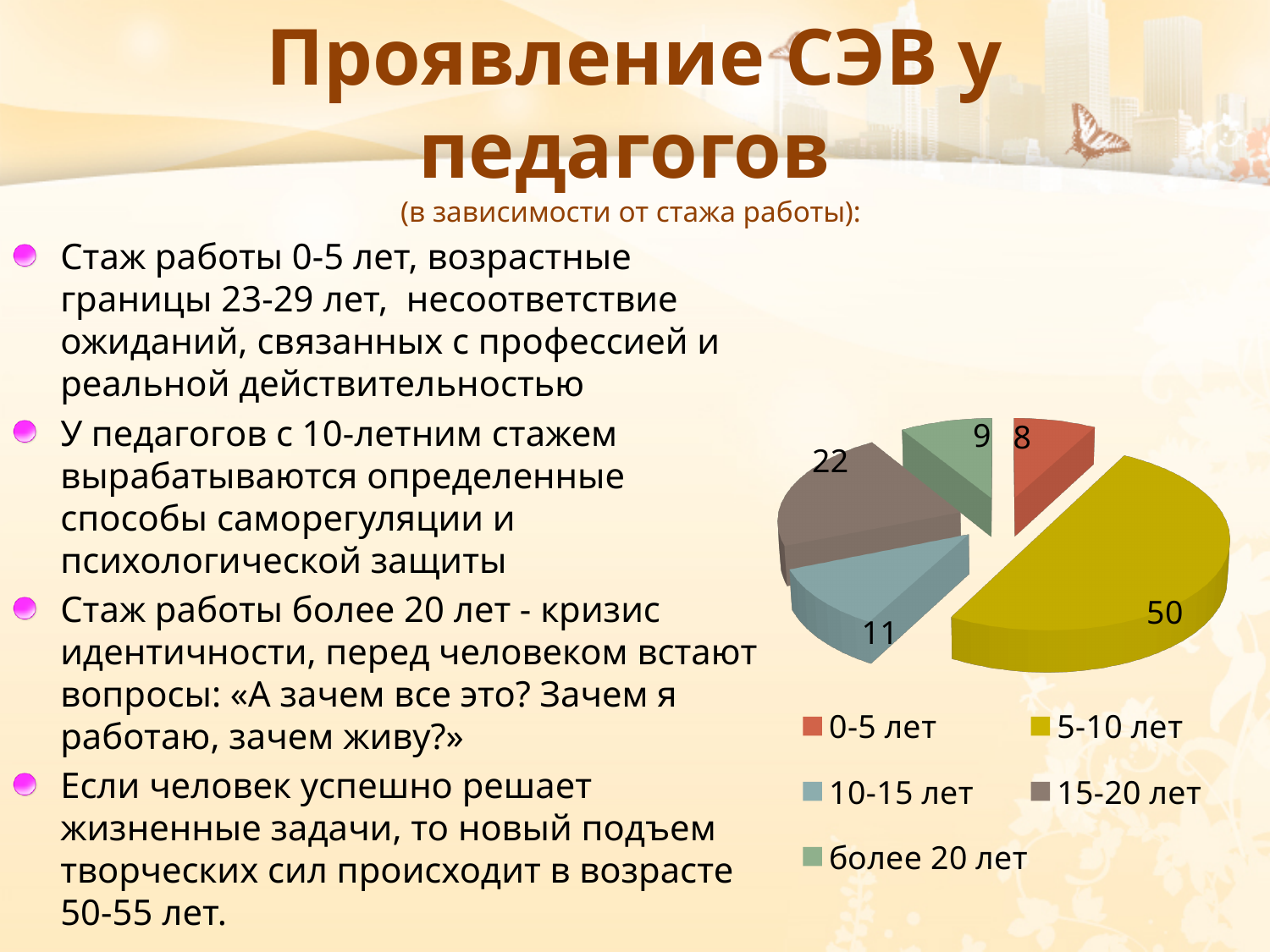
What share of the pie does the "5-10 лет" slice represent? 50% What is the value for the "более 20 лет" slice? 9 Which category has the largest slice of the pie? 5-10 лет What is the value for the "5-10 лет" slice? 50 Which category has the smallest slice of the pie? 0-5 лет What colour is the "5-10 лет" slice in the pie chart? Yellow Which is larger, the value for "10-15 лет" or the value for "15-20 лет"? 15-20 лет What type of chart is shown on the slide? Pie chart How many categories does the pie chart have? 5 What is the value for the "0-5 лет" slice? 8 What is the value for the "15-20 лет" slice? 22 What is the difference between the values for "5-10 лет" and "15-20 лет"? 28